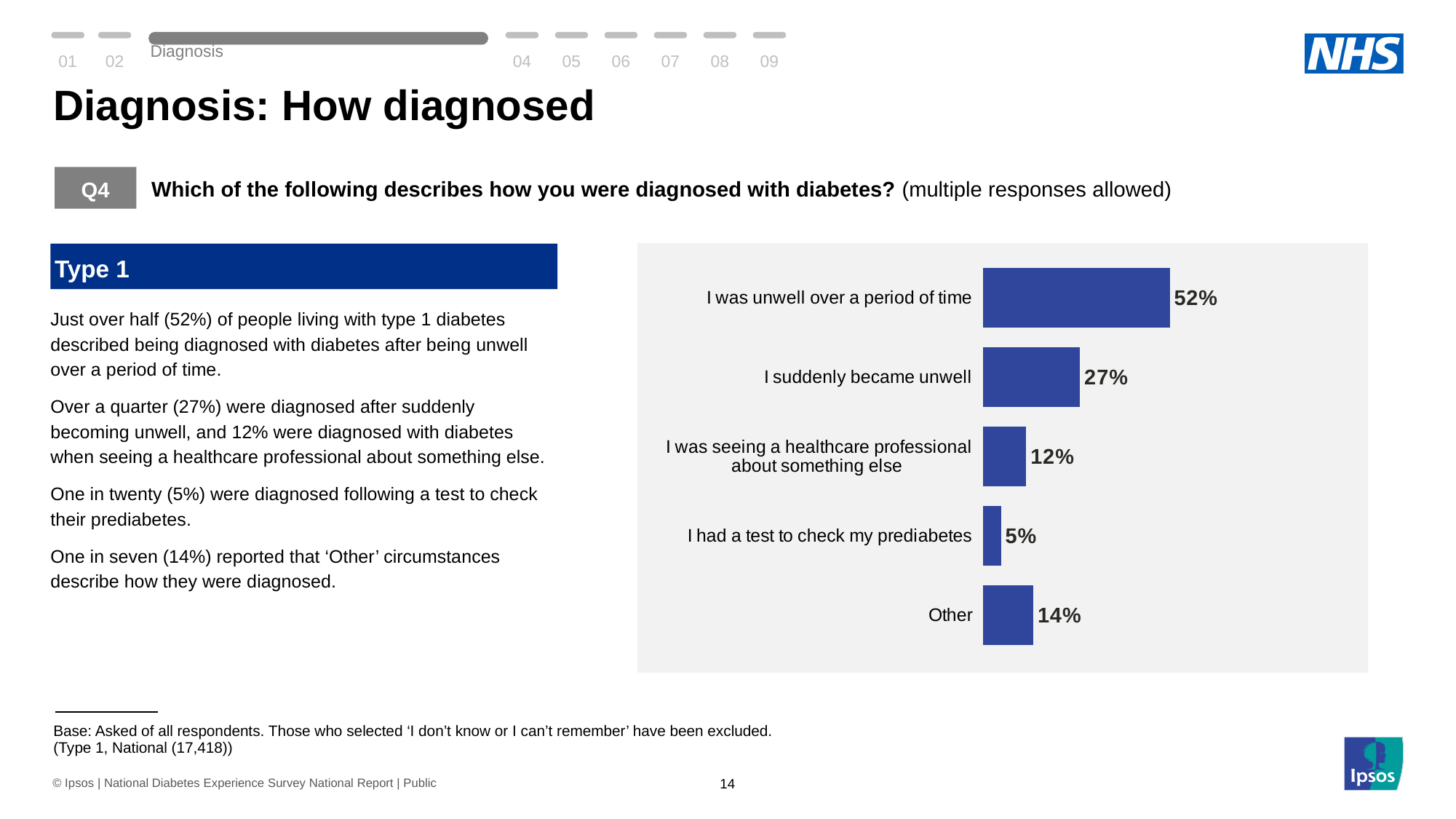
How many categories are shown in the chart? 5 What percentage of respondents said 'I had a test to check my prediabetes'? 5% What is the difference in percentage points between 'I was unwell over a period of time' and 'I suddenly became unwell'? 25 percentage points What is the difference in percentage points between 'Other' and 'I had a test to check my prediabetes'? 9 percentage points What percentage of respondents selected 'Other'? 14% What percentage of respondents said 'I was seeing a healthcare professional about something else'? 12% What percentage of respondents said 'I was unwell over a period of time'? 52% Which is larger: the value for 'Other' or the value for 'I was seeing a healthcare professional about something else'? Other What kind of chart is shown on the slide? Bar chart What percentage of respondents said 'I suddenly became unwell'? 27% Which category has the highest percentage? I was unwell over a period of time Which category has the lowest percentage? I had a test to check my prediabetes